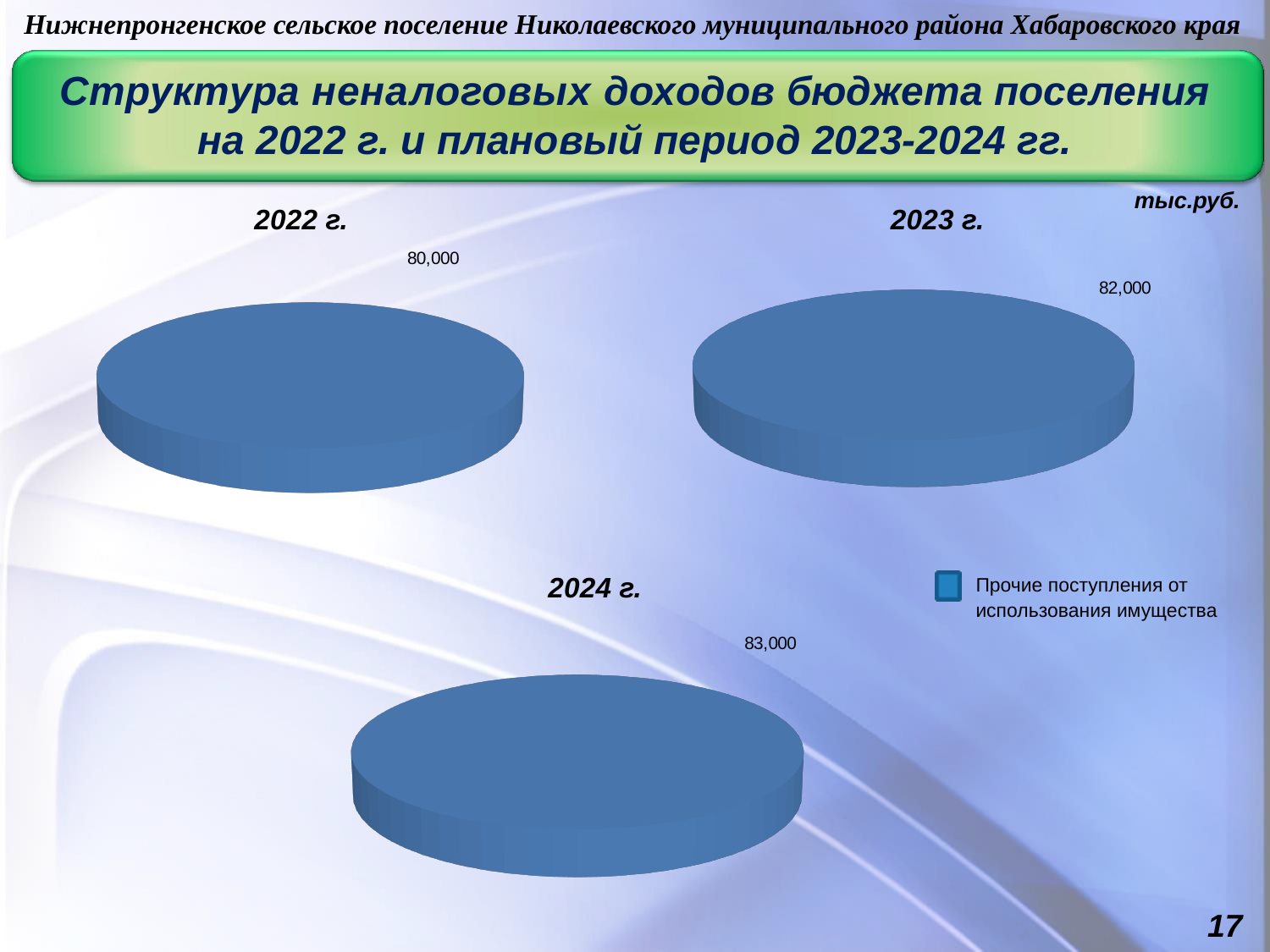
Which is larger: the value in the "2023 г." chart or the value in the "2024 г." chart? 2024 г. What is the legend entry shown next to the blue square on the slide? Прочие поступления от использования имущества Which of the three year charts shows the lowest value? 2022 г. In the chart titled "2022 г.", what is the value shown for the single slice? 80,000 How many pie charts are shown on the slide? 3 What is the difference between the value in the "2024 г." chart and the value in the "2022 г." chart? 3,000 In the chart titled "2023 г.", what value is printed on the pie? 82,000 How many slices does the "2024 г." pie chart contain? 1 What kind of chart is the "2022 г." chart? Pie chart In the chart titled "2024 г.", what value is printed on the pie? 83,000 What is the difference between the value in the "2023 г." chart and the value in the "2022 г." chart? 2,000 What share of the "2023 г." pie does the single slice "Прочие поступления от использования имущества" represent? 100%